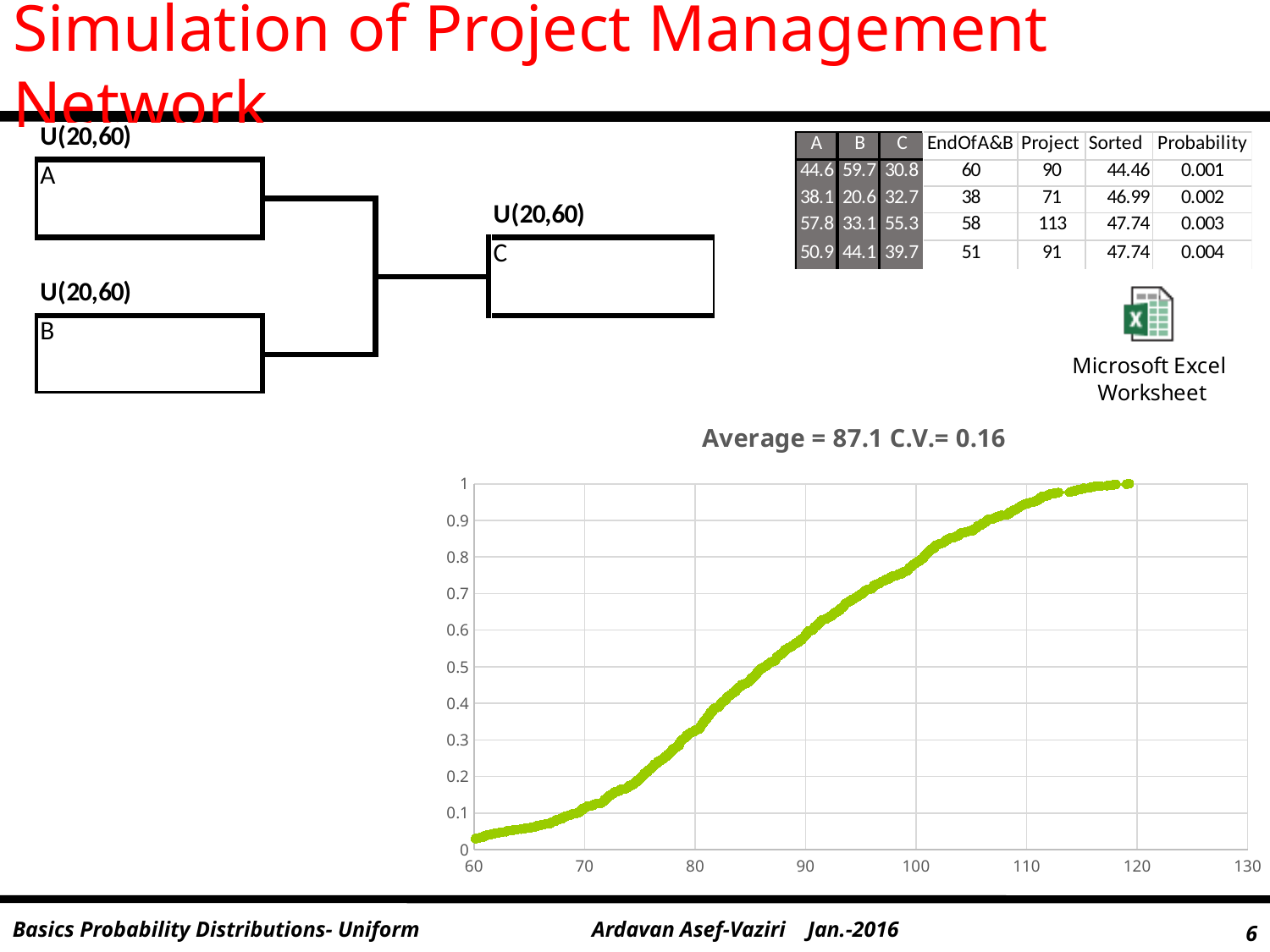
What kind of chart is shown on the slide? scatter chart Do the plotted values rise or fall as the x axis increases from 60 to 120? rise Is the plotted value at x = 80 greater or less than 0.4? less Is the plotted value at x = 90 greater or less than 0.5? greater Is the plotted value at x = 110 greater or less than 0.9? greater What is the highest value shown on the x axis of the chart? 130 Is the plotted value at x = 110 larger than the plotted value at x = 90? yes What is the title of the chart? Average = 87.1 C.V.= 0.16